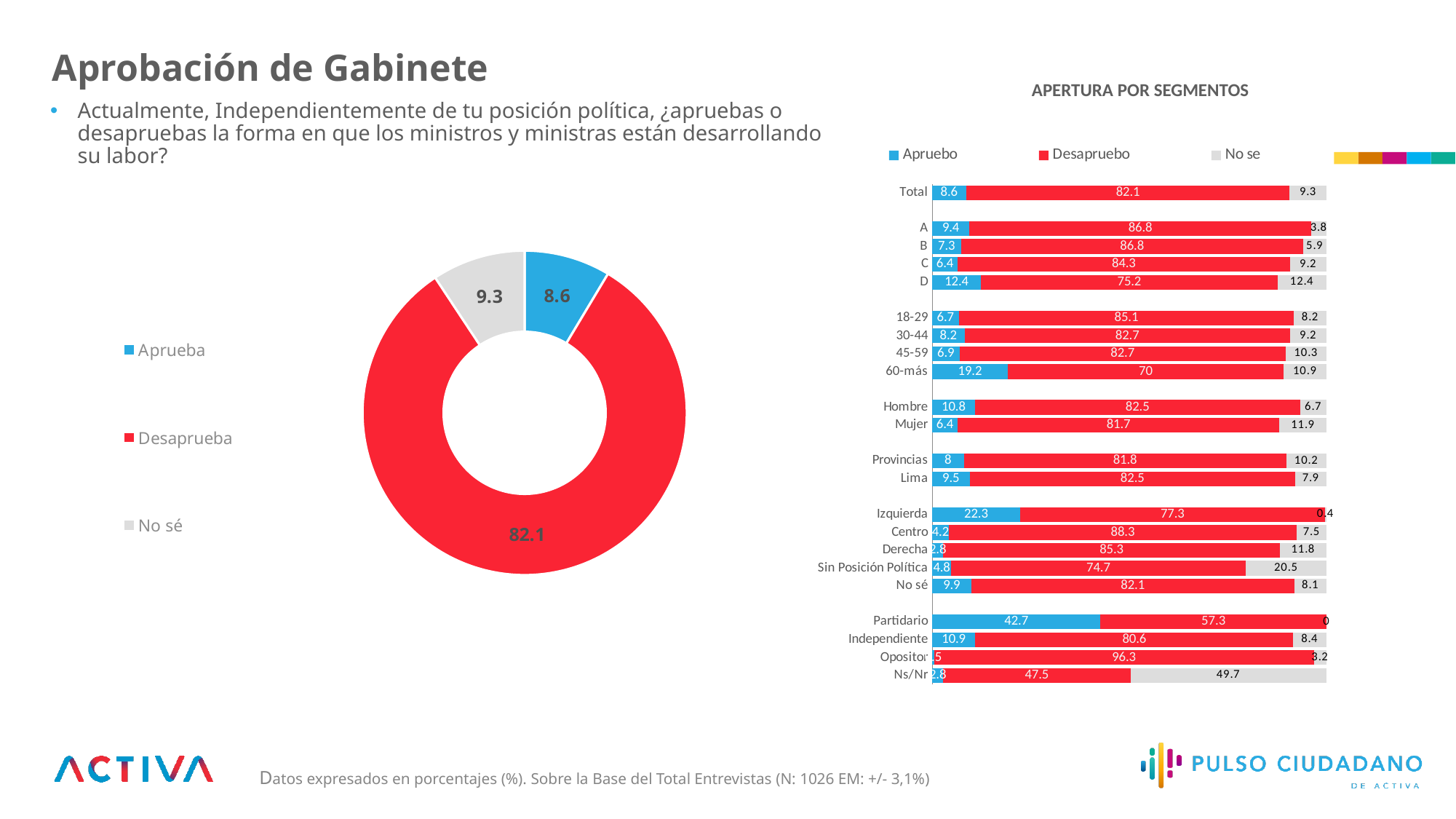
In the 'APERTURA POR SEGMENTOS' chart, which segment has the highest Apruebo value? Partidario In the 'APERTURA POR SEGMENTOS' chart, what is the Desapruebo value for Opositor? 96.3 What kind of chart is the chart on the left of the slide? pie chart In the 'APERTURA POR SEGMENTOS' chart, which segment has the highest No se value? Ns/Nr In the 'APERTURA POR SEGMENTOS' chart, what is the difference between the Desapruebo values for Hombre and Mujer? 0.8 In the 'APERTURA POR SEGMENTOS' chart, what is the No se value for Sin Posición Política? 20.5 In the 'APERTURA POR SEGMENTOS' chart, what is the Apruebo value for 60-más? 19.2 What kind of chart is the 'APERTURA POR SEGMENTOS' chart? bar chart How many series does the legend of the 'APERTURA POR SEGMENTOS' chart list? 3 In the pie chart on the left, what is the value for Desaprueba? 82.1 How many slices does the pie chart on the left have? 3 In the pie chart on the left, what is the value for No sé? 9.3